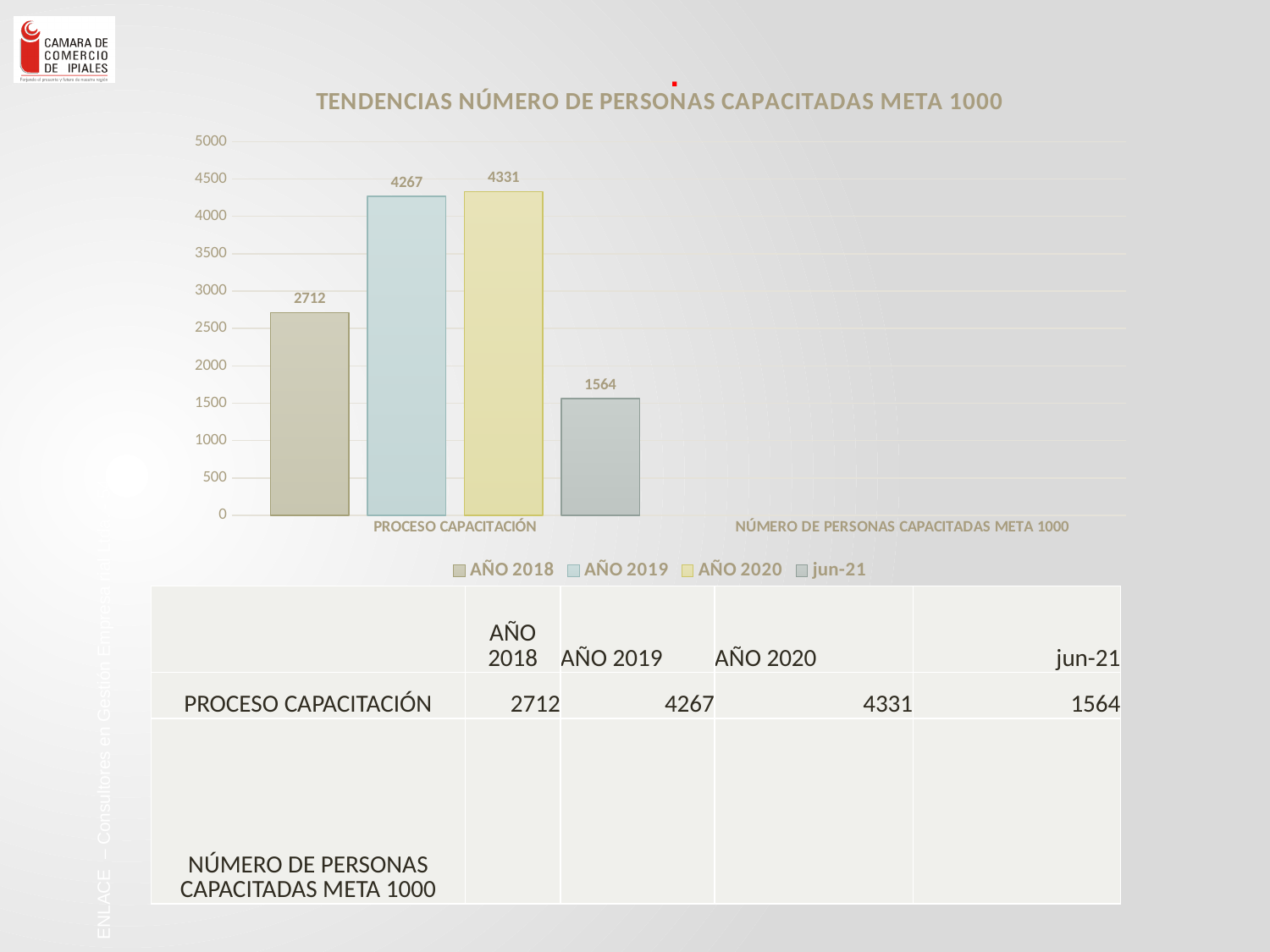
What is the value for jun-21 in the PROCESO CAPACITACIÓN category? 1564 What is the value for AÑO 2020 in the PROCESO CAPACITACIÓN category? 4331 What is the value for AÑO 2019 in the PROCESO CAPACITACIÓN category? 4267 What is the title of the chart? TENDENCIAS NÚMERO DE PERSONAS CAPACITADAS META 1000 How many series does the legend list? 4 Which series has the lowest value for PROCESO CAPACITACIÓN? jun-21 What is the value for AÑO 2018 in the PROCESO CAPACITACIÓN category? 2712 Which series has the highest value for PROCESO CAPACITACIÓN? AÑO 2020 Which is larger for PROCESO CAPACITACIÓN: the AÑO 2018 value or the jun-21 value? AÑO 2018 What is the difference between the AÑO 2019 and AÑO 2018 values for PROCESO CAPACITACIÓN? 1555 What is the difference between the AÑO 2020 and jun-21 values for PROCESO CAPACITACIÓN? 2767 What kind of chart is shown on the slide? Bar chart